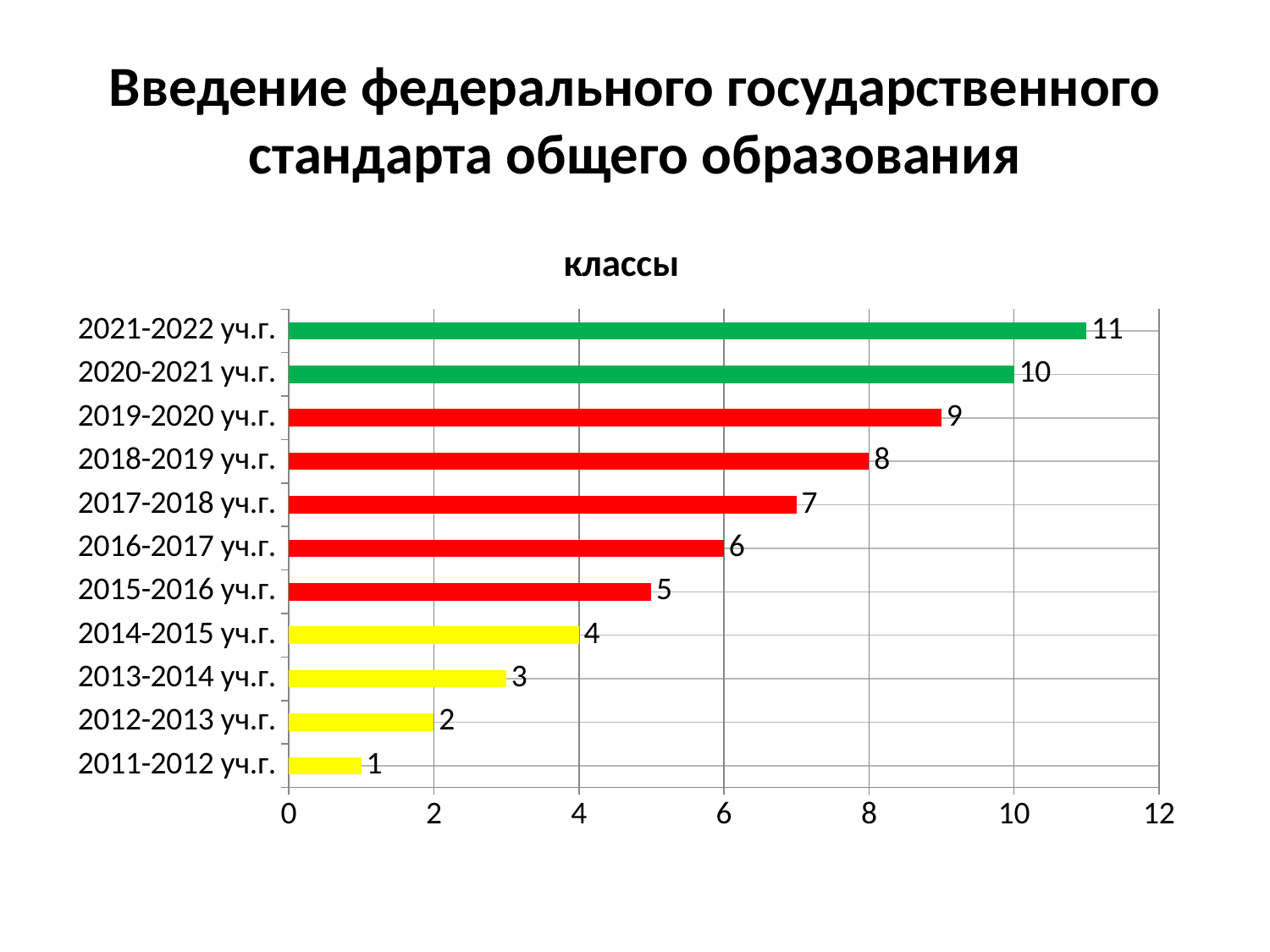
What is the value for 2020-2021 уч.г.? 10 Which category has the highest value? 2021-2022 уч.г. Do the values rise or fall from 2011-2012 уч.г. to 2021-2022 уч.г.? rise Is the value for 2019-2020 уч.г. greater or less than 8? greater How many categories are shown in the chart? 11 What is the value for 2012-2013 уч.г.? 2 What is the value for 2017-2018 уч.г.? 7 What kind of chart is this? bar chart What is the title of the chart? классы Which category has the lowest value? 2011-2012 уч.г. What is the difference between the values for 2021-2022 уч.г. and 2015-2016 уч.г.? 6 Which is larger, the value for 2018-2019 уч.г. or the value for 2014-2015 уч.г.? 2018-2019 уч.г.